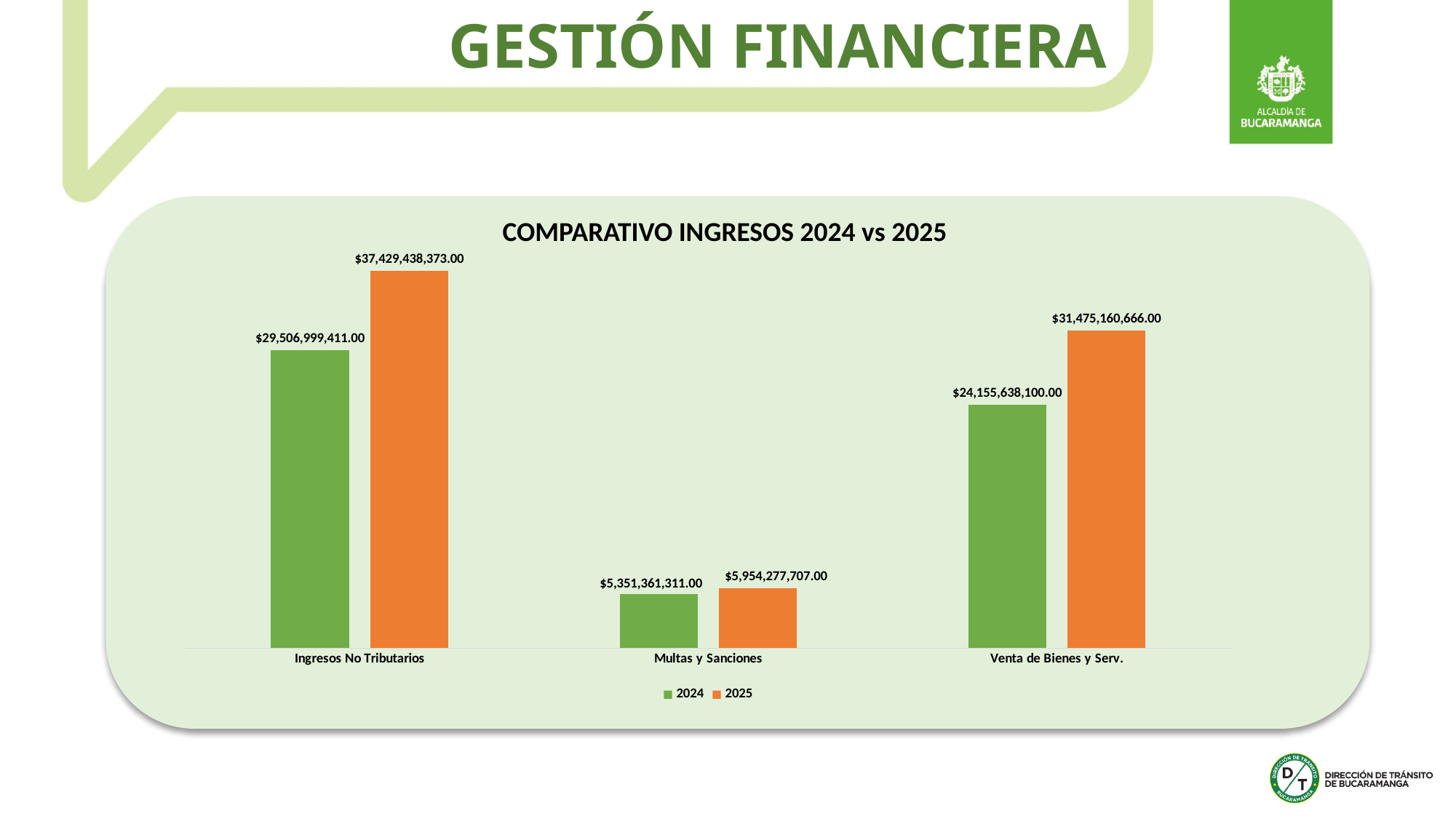
How many series does the legend list? 2 Which category has the lowest 2024 value? Multas y Sanciones What is the difference between the 2025 and 2024 values for Ingresos No Tributarios? $7,922,438,962.00 What is the 2025 value for Ingresos No Tributarios? $37,429,438,373.00 What type of chart is shown on the slide? Bar chart What is the 2024 value for Multas y Sanciones? $5,351,361,311.00 Which is larger for Multas y Sanciones, the 2024 value or the 2025 value? 2025 What is the 2025 value for Venta de Bienes y Serv.? $31,475,160,666.00 What is the difference between the 2025 and 2024 values for Venta de Bienes y Serv.? $7,319,522,566.00 Which category has the highest 2025 value? Ingresos No Tributarios How many categories are shown on the x axis? 3 What is the 2024 value for Venta de Bienes y Serv.? $24,155,638,100.00